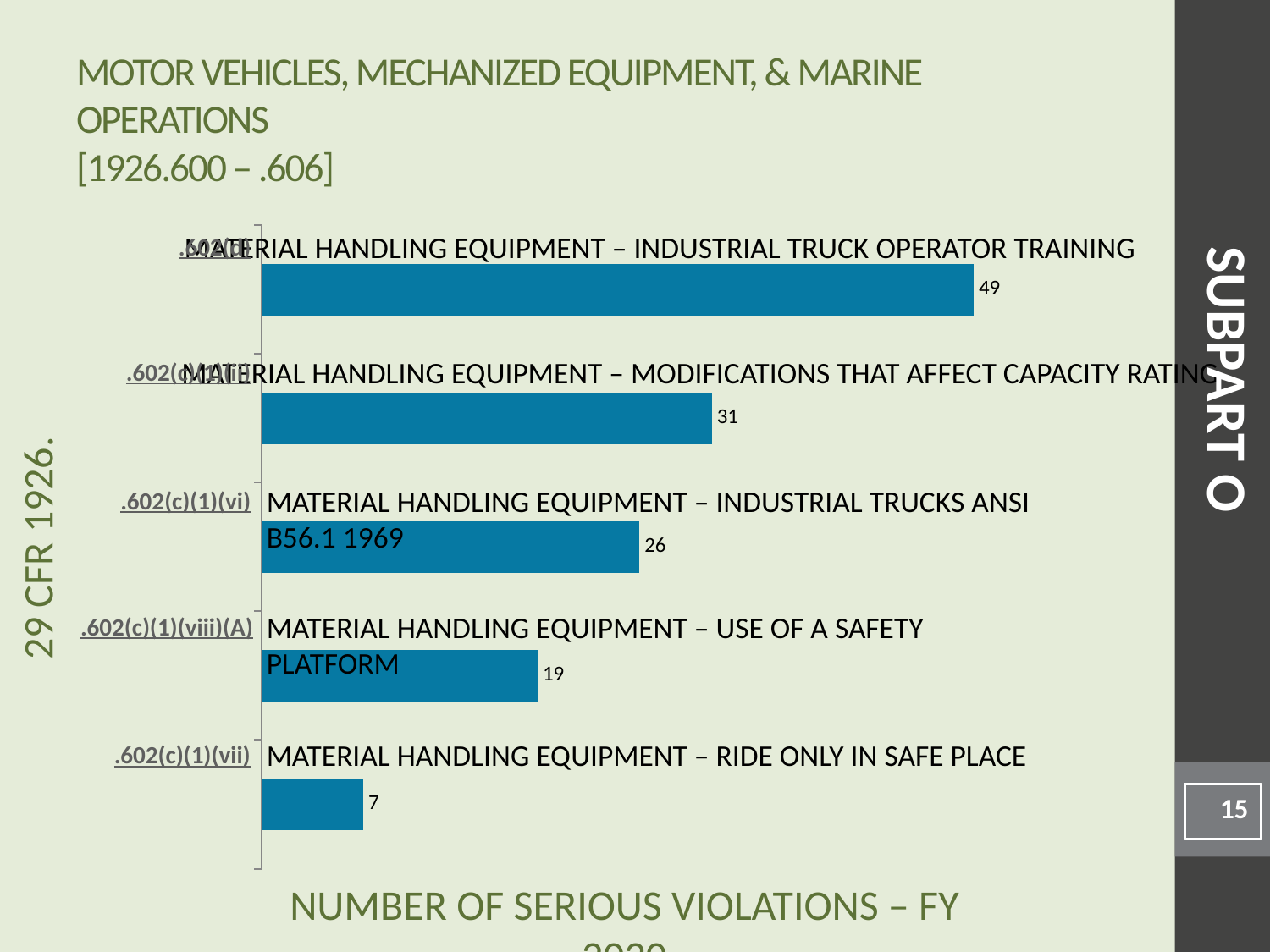
What is the number of serious violations for Material Handling Equipment – Industrial Truck Operator Training? 49 What is the value shown for .602(c)(1)(viii)(A), Material Handling Equipment – Use of a Safety Platform? 19 What is the difference between the violations for Use of a Safety Platform and Ride Only in Safe Place? 12 What is the number of serious violations for Material Handling Equipment – Modifications That Affect Capacity Rating? 31 How many categories are plotted in the chart? 5 Which category has the highest number of serious violations? Material Handling Equipment – Industrial Truck Operator Training What type of chart is shown on the slide? Bar chart What is the difference between the violations for Industrial Truck Operator Training and Modifications That Affect Capacity Rating? 18 Which has more serious violations: Industrial Trucks ANSI B56.1 1969 or Use of a Safety Platform? Industrial Trucks ANSI B56.1 1969 What is the value shown for .602(c)(1)(vi), Material Handling Equipment – Industrial Trucks ANSI B56.1 1969? 26 Which category has the lowest number of serious violations? Material Handling Equipment – Ride Only in Safe Place What is the value shown for .602(c)(1)(vii), Material Handling Equipment – Ride Only in Safe Place? 7